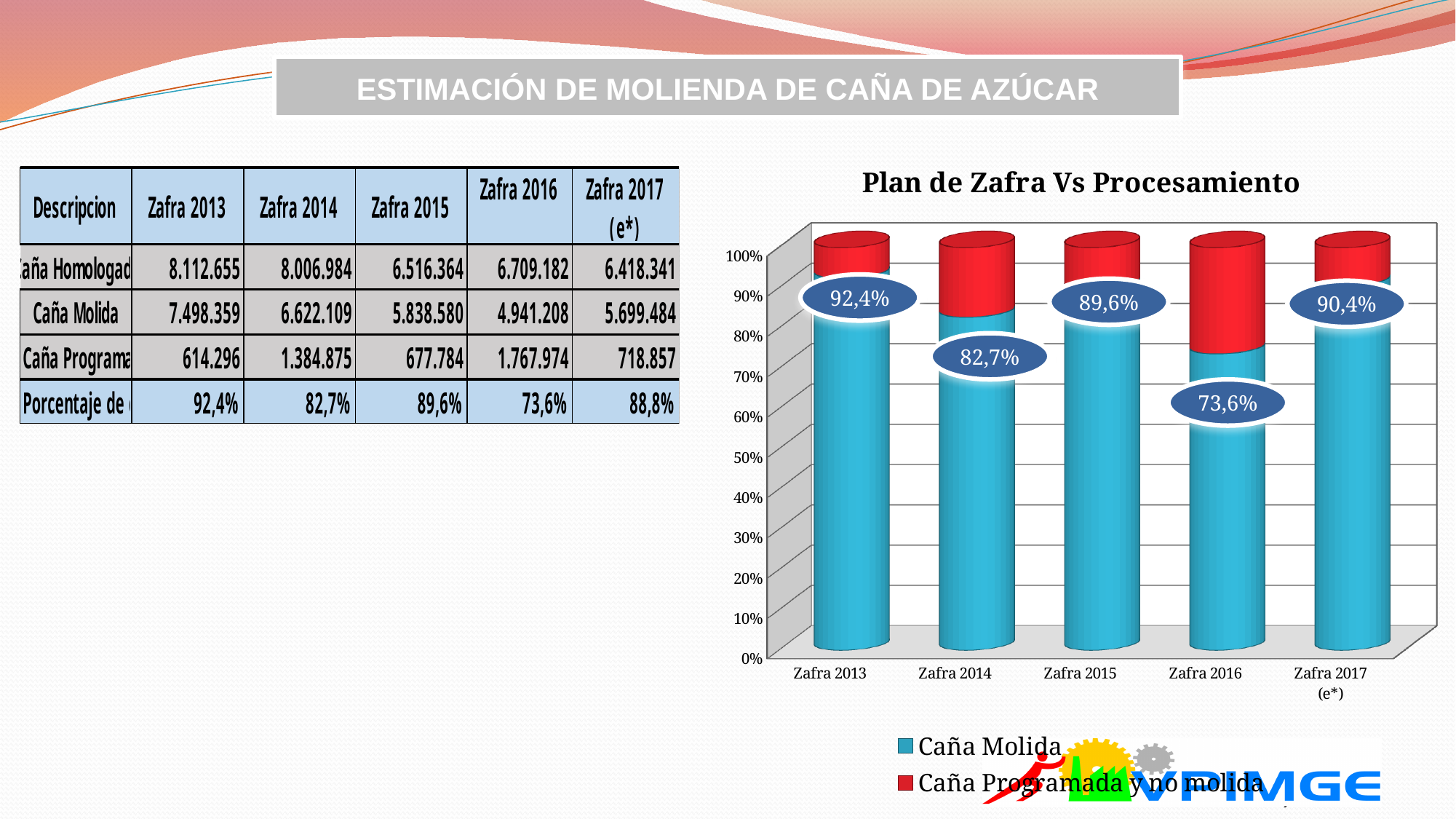
What is the Caña Molida percentage for Zafra 2013 in the chart? 92,4% What is the title of the chart? Plan de Zafra Vs Procesamiento What is the Caña Molida percentage for Zafra 2014 in the chart? 82,7% What is the Caña Molida percentage labelled for Zafra 2017 (e*) in the chart? 90,4% What is the Caña Molida percentage for Zafra 2016 in the chart? 73,6% Which has a larger Caña Molida percentage, Zafra 2015 or Zafra 2014? Zafra 2015 Is the Caña Molida value for Zafra 2016 greater or less than 80%? less How many series does the chart legend list? 2 How many zafras (categories) are shown on the x axis of the chart? 5 What is the difference between the Caña Molida percentages for Zafra 2013 and Zafra 2016? 18,8% Which zafra has the highest Caña Molida percentage in the chart? Zafra 2013 Which zafra has the lowest Caña Molida percentage in the chart? Zafra 2016